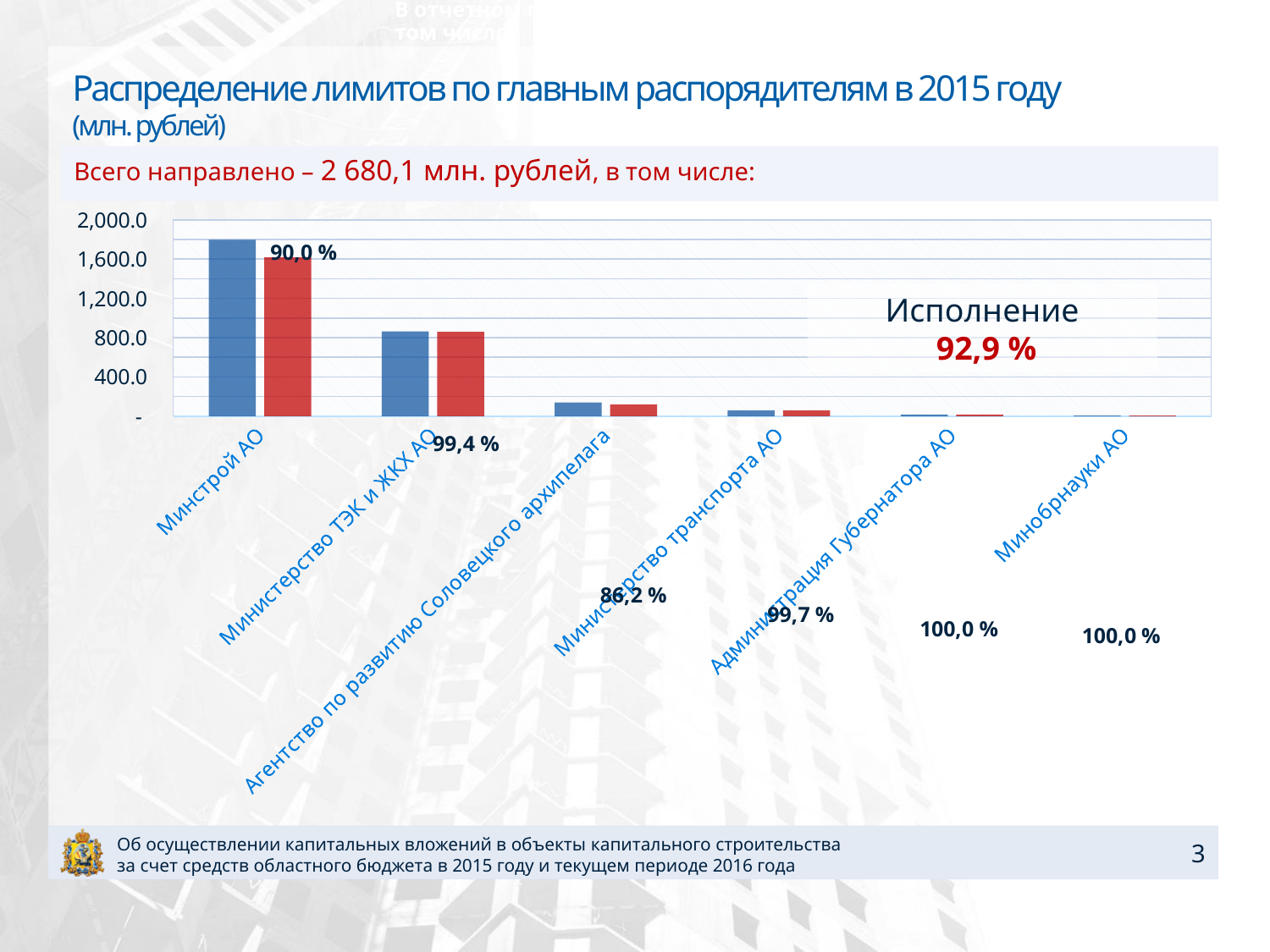
What execution percentage is shown next to Минстрой АО? 90,0 % Which category has the smallest bars in the chart? Минобрнауки АО Is the value of the blue bar for Министерство ТЭК и ЖКХ АО greater or less than 400.0? greater How many categories (главные распорядители) are shown on the x axis of the chart? 6 Which category has the tallest bars in the chart? Минстрой АО What overall execution percentage (Исполнение) is printed on the chart? 92,9 % Which has larger bars: Минстрой АО or Министерство транспорта АО? Минстрой АО Is the value of the blue bar for Агентство по развитию Соловецкого архипелага greater or less than 400.0? less What kind of chart is shown on the slide? bar chart What execution percentage is shown for Агентство по развитию Соловецкого архипелага? 86,2 % Do the bar values rise or fall moving from left to right along the x axis? fall Is the value of the blue bar for Минстрой АО greater or less than 1,200.0? greater